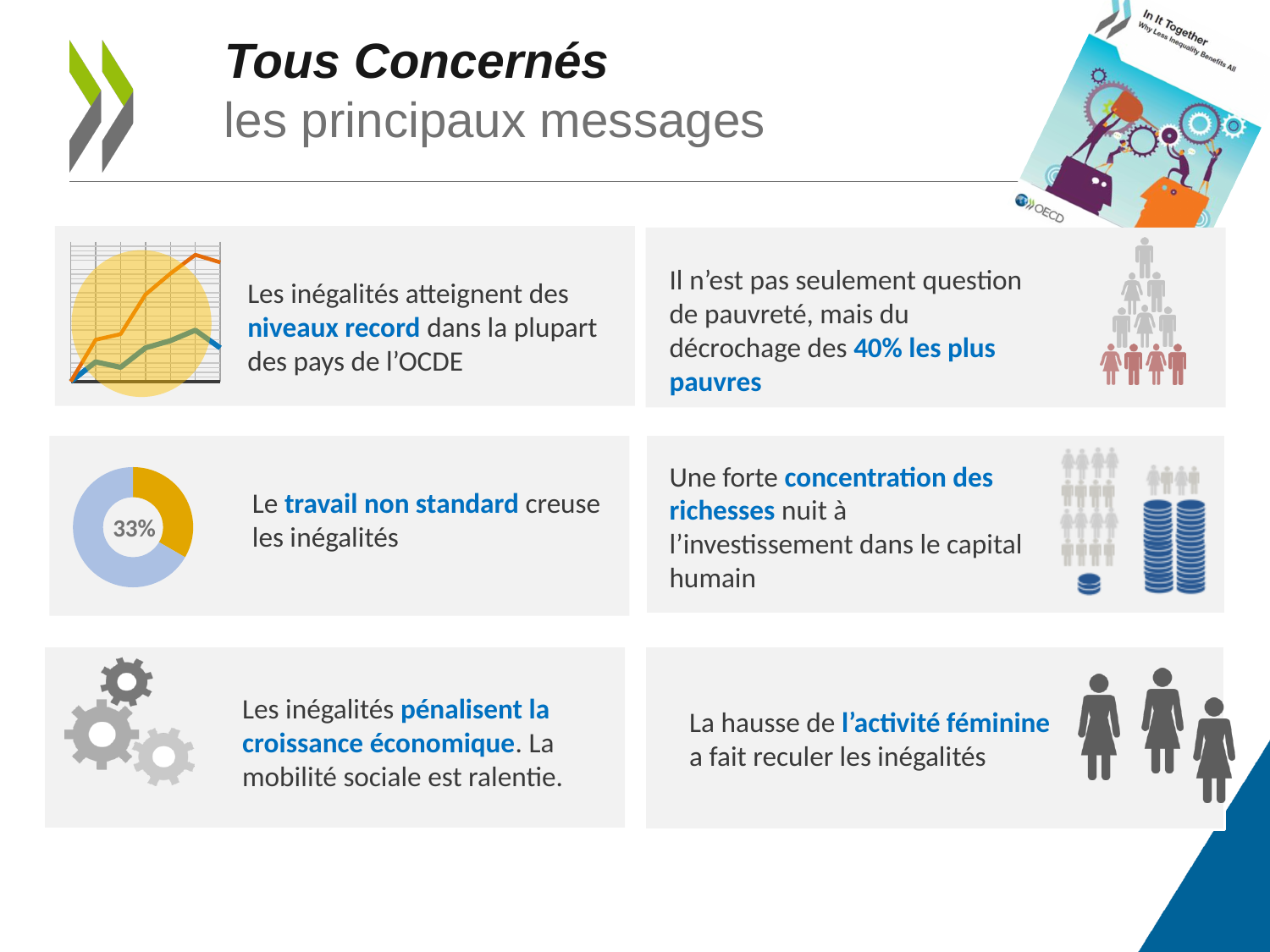
In the donut chart in the 'travail non standard' box, which slice is larger, the yellow one or the light blue one? The light blue one How many lines are plotted in the small line chart in the top-left box? 2 In the small line chart in the top-left box, which line reaches higher, the orange one or the blue-green one? The orange one In the small line chart in the top-left box, do the lines generally rise or fall from left to right? Rise What colours are the two lines in the small line chart in the top-left box? Orange and blue-green What value is printed in the centre of the donut chart next to 'Le travail non standard creuse les inégalités'? 33% What share of the donut chart in the 'travail non standard' box does the yellow slice represent? 33% What colour is the larger slice of the donut chart in the 'travail non standard' box? Light blue How many slices does the donut chart in the 'travail non standard' box have? 2 What kind of chart is shown in the top-left box about 'niveaux record'? Line chart What kind of chart is shown in the box about 'travail non standard'? Pie (donut) chart